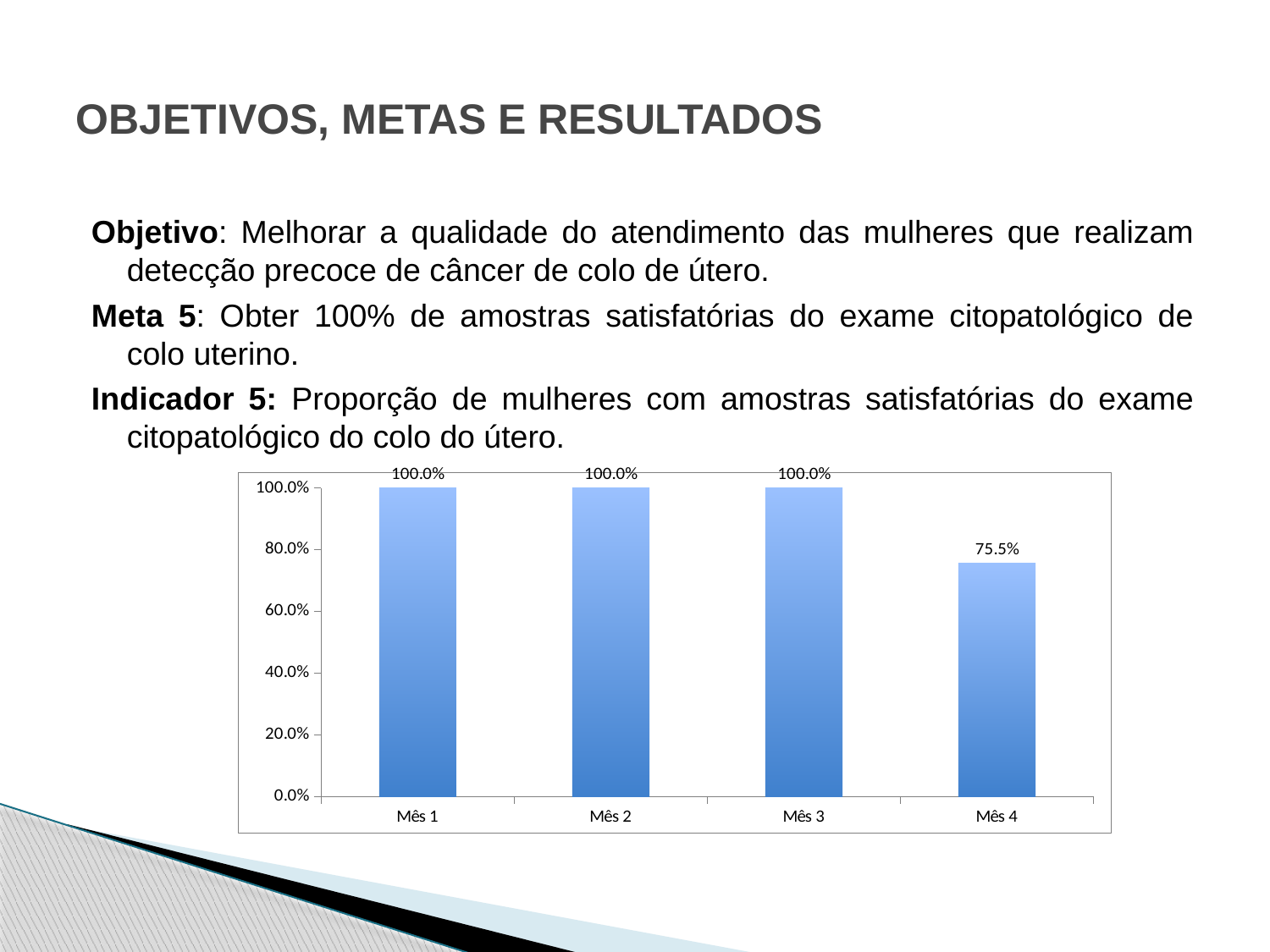
How many months are shown on the x axis? 4 Which is larger, the value for Mês 2 or the value for Mês 4? Mês 2 How many months have a value of 100.0%? 3 What is the highest tick label on the y axis? 100.0% Is the value for Mês 4 greater or less than 80.0%? less What is the value for Mês 3? 100.0% What is the difference between the values for Mês 3 and Mês 4? 24.5% What is the value for Mês 1? 100.0% What is the value for Mês 4? 75.5% What kind of chart is shown on the slide? bar chart Do the values rise, fall or stay the same from Mês 3 to Mês 4? fall Which month has the lowest value? Mês 4